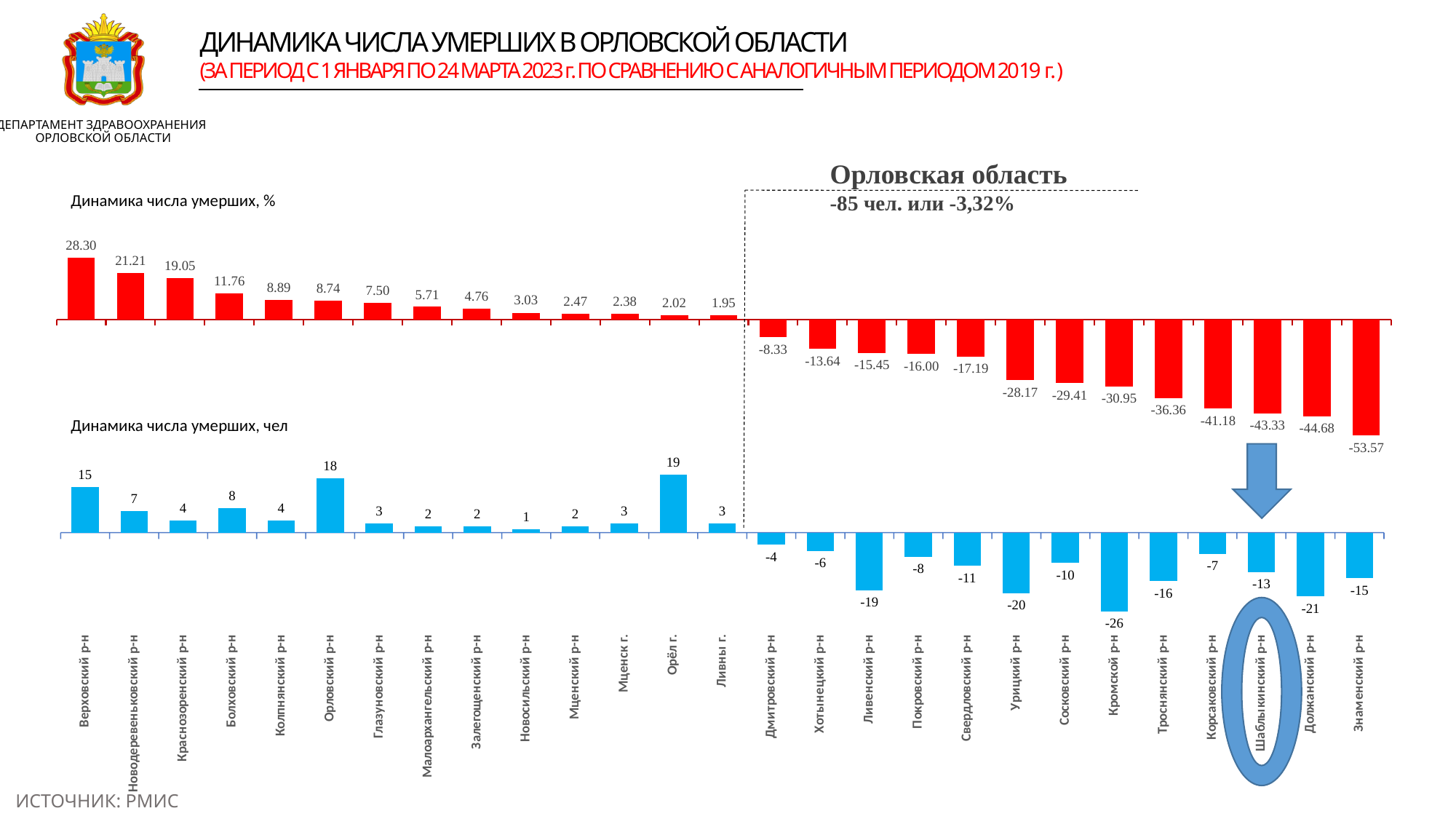
In the top chart 'Динамика числа умерших, %', do the values rise or fall from left to right along the x axis? fall In the top chart 'Динамика числа умерших, %', what is the value for Знаменский р-н? -53.57 In the bottom chart 'Динамика числа умерших, чел', which category has the lowest value? Кромской р-н In the bottom chart 'Динамика числа умерших, чел', what is the value for Орёл г.? 19 What colour are the bars in the bottom chart 'Динамика числа умерших, чел'? blue What kind of chart is the top chart 'Динамика числа умерших, %'? bar chart In the top chart 'Динамика числа умерших, %', what is the value for Верховский р-н? 28.30 In the top chart 'Динамика числа умерших, %', which is larger: the value for Болховский р-н or the value for Колпнянский р-н? Болховский р-н In the bottom chart 'Динамика числа умерших, чел', what is the value for Кромской р-н? -26 In the bottom chart 'Динамика числа умерших, чел', what is the difference between the values for Орёл г. and Орловский р-н? 1 In the top chart 'Динамика числа умерших, %', which category has the highest value? Верховский р-н How many categories are shown on the x axis of the bottom chart 'Динамика числа умерших, чел'? 27